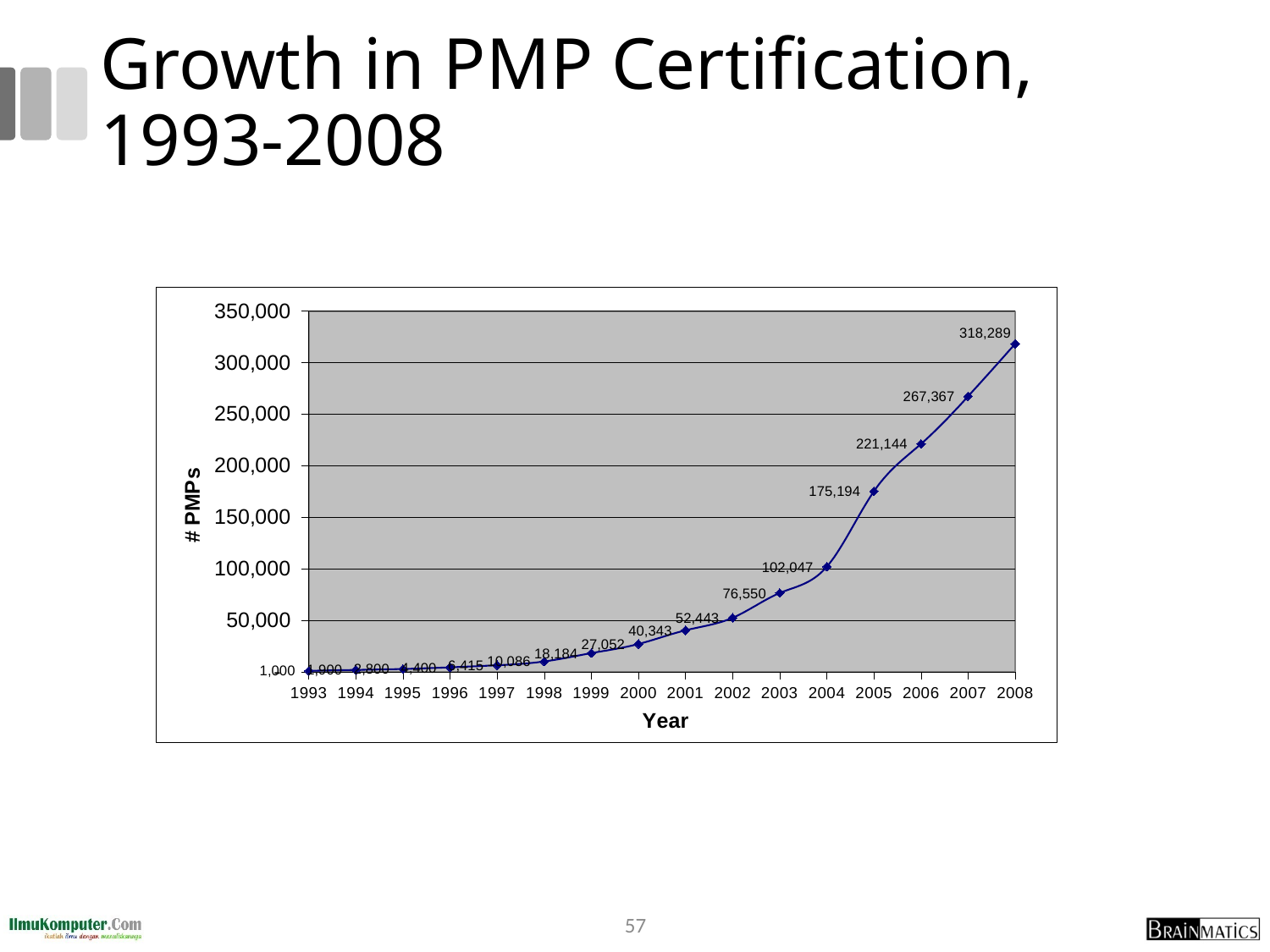
What is the label of the y-axis? # PMPs What is the difference in the number of PMPs between 2004 and 2003? 25,497 What type of chart is shown on the slide? line chart What is the number of PMPs in 2005? 175,194 Which year has the highest number of PMPs? 2008 Which year has more PMPs, 2006 or 2004? 2006 What is the number of PMPs in 2002? 52,443 What is the number of PMPs in 2008? 318,289 What is the difference in the number of PMPs between 2008 and 2007? 50,922 Is the number of PMPs in 2007 greater or less than 250,000? greater What is the number of PMPs in 1999? 18,184 Does the number of PMPs rise or fall from 1993 to 2008? rise